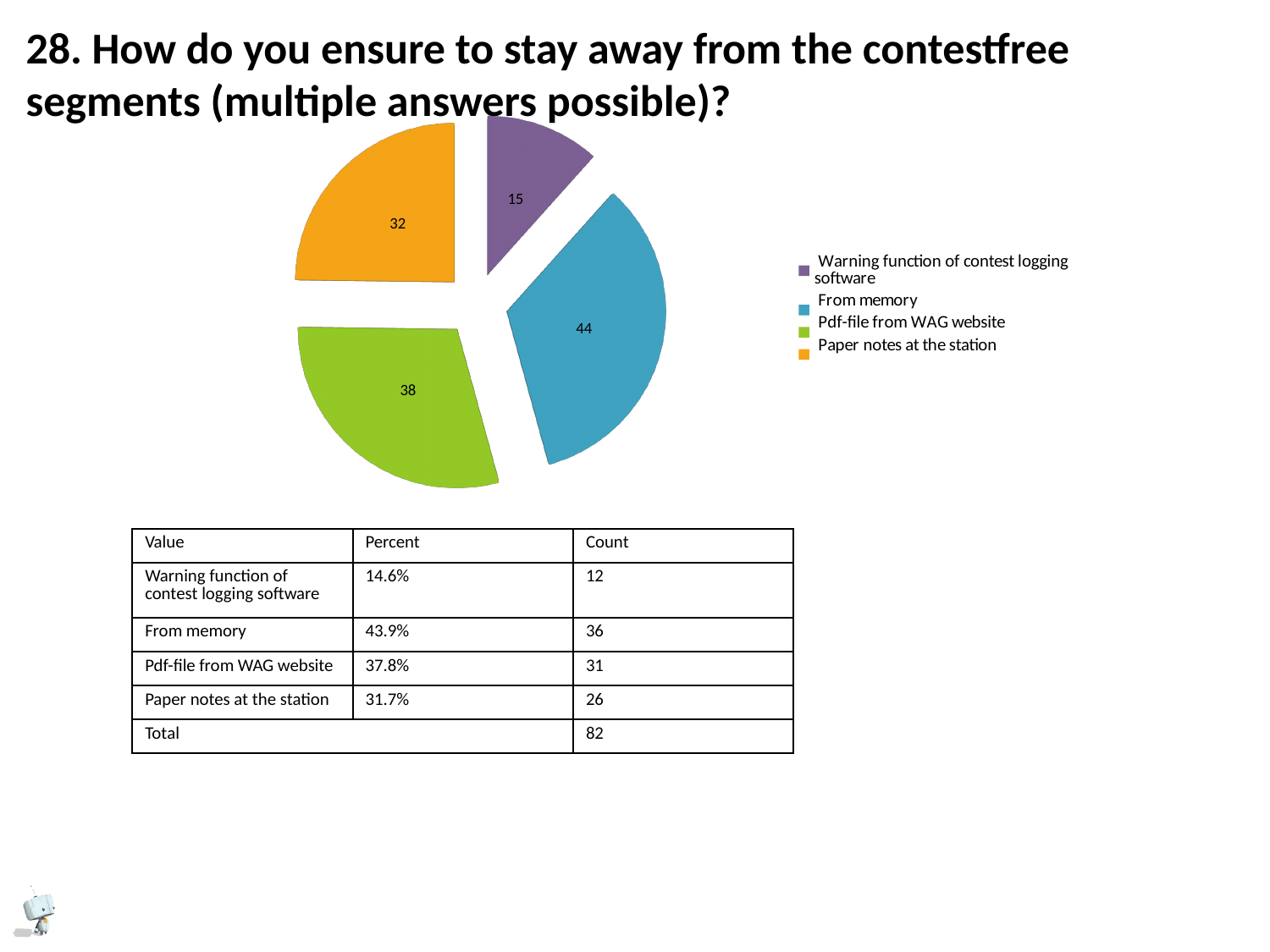
What kind of chart is shown on the slide? Pie chart Which is larger, the 'Pdf-file from WAG website' slice or the 'Paper notes at the station' slice? Pdf-file from WAG website What value is shown for the 'Paper notes at the station' slice? 32 Which category has the smallest slice in the pie chart? Warning function of contest logging software Which category has the largest slice in the pie chart? From memory What value is shown for the 'From memory' slice of the pie chart? 44 How many slices does the pie chart have? 4 What colour is the 'From memory' slice in the pie chart? Blue What is the difference between the 'From memory' value and the 'Warning function of contest logging software' value? 29 What value is shown for the 'Warning function of contest logging software' slice? 15 What is the difference between the 'Pdf-file from WAG website' value and the 'Paper notes at the station' value? 6 What value is shown for the 'Pdf-file from WAG website' slice? 38